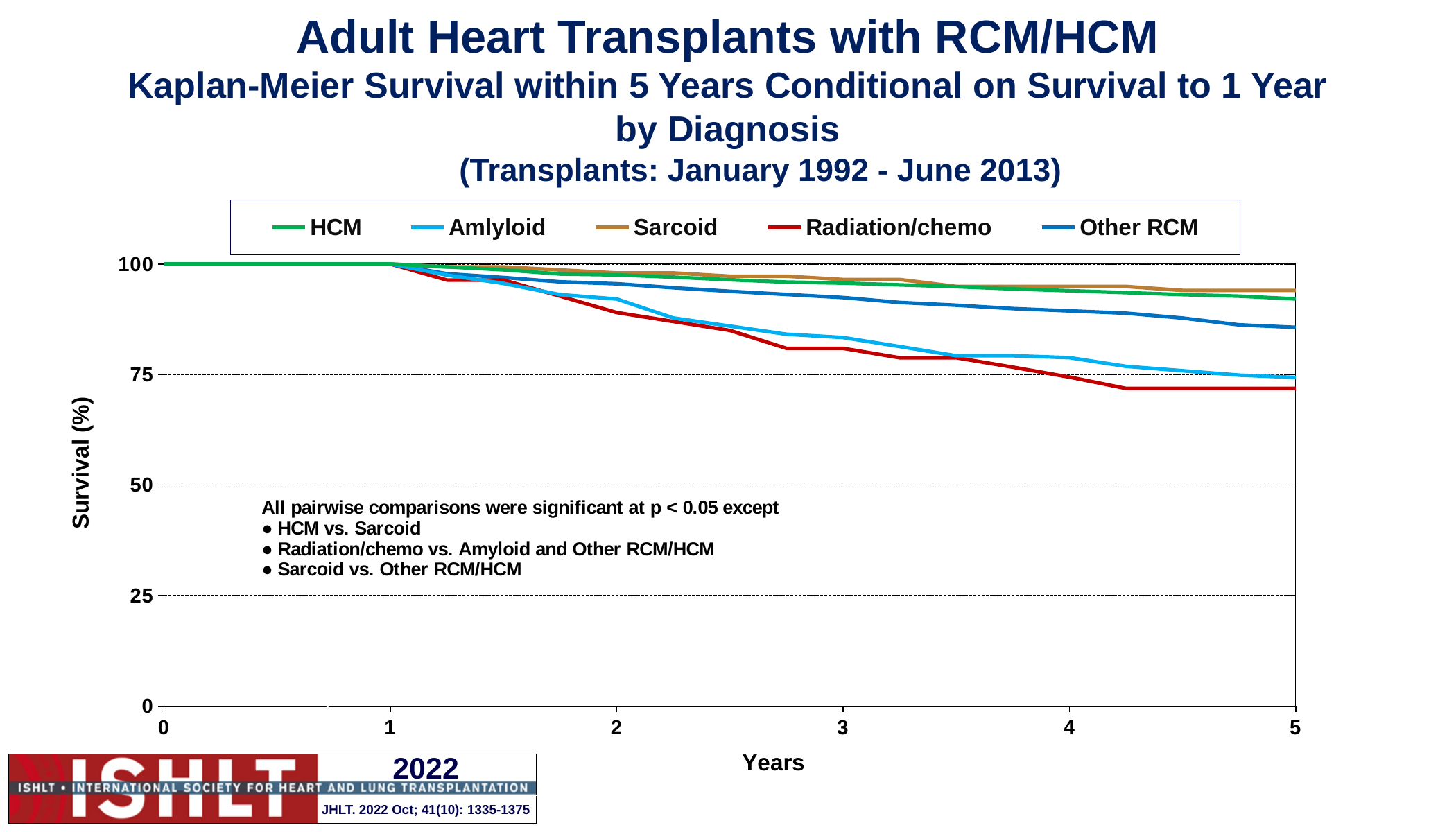
What colour is the line for Radiation/chemo? Red At year 5, which has higher survival: Sarcoid or Radiation/chemo? Sarcoid At year 4, which has higher survival: Other RCM or Amyloid? Other RCM Is the survival value for Other RCM at year 5 greater or less than 75? greater What is the label of the y axis? Survival (%) Is the survival value for Radiation/chemo at year 5 greater or less than 75? less Which diagnosis group has the lowest survival at year 4? Radiation/chemo Do the survival curves rise or fall as years increase from 1 to 5? Fall Is the survival value for Amyloid at year 3 greater or less than 75? greater How many series does the legend list? 5 What kind of chart is shown on the slide? Line chart Which diagnosis group has the highest survival at year 5? Sarcoid